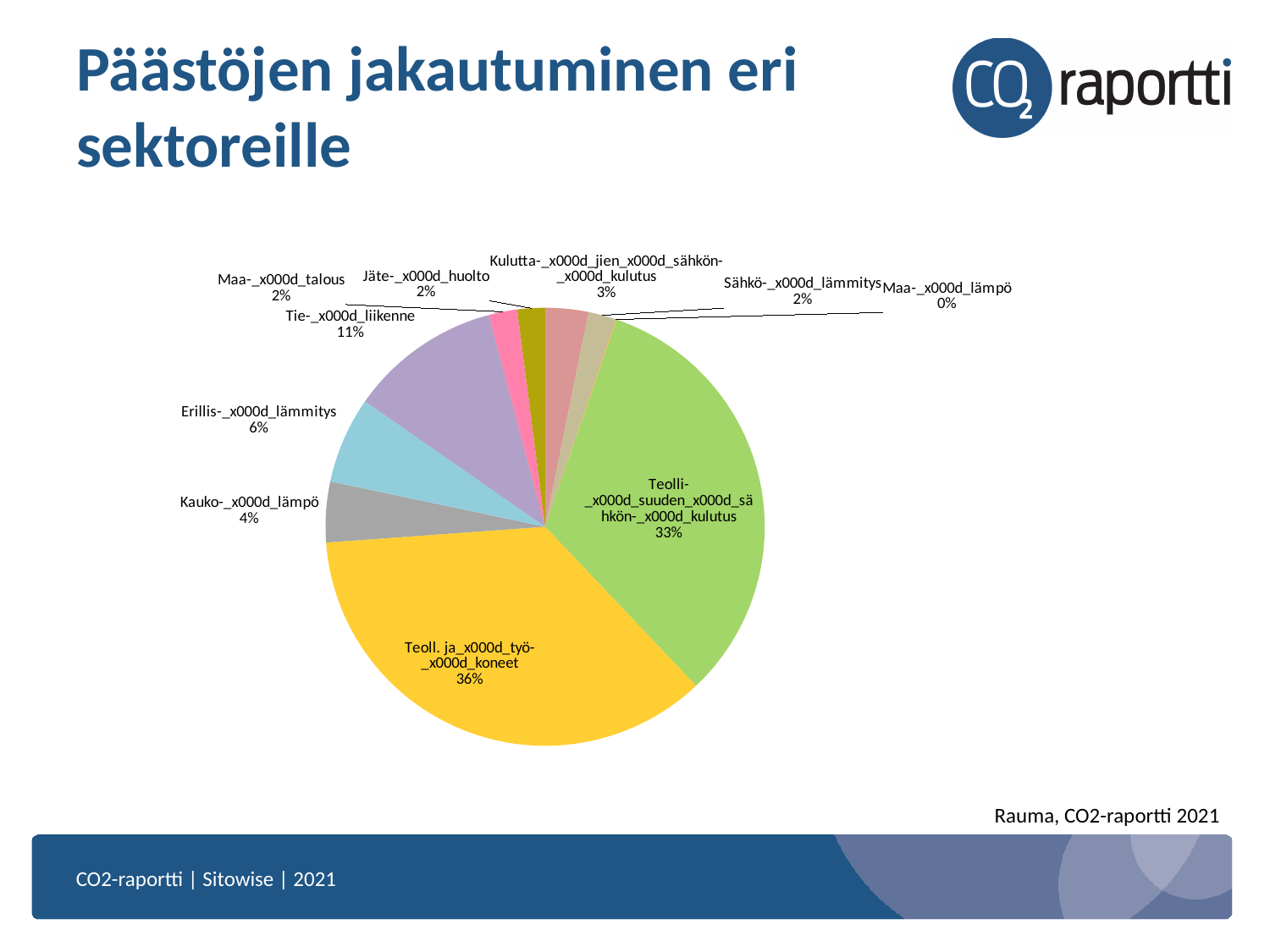
What percentage is shown for the slice labelled 'Kulutta-_x000d_jien_x000d_sähkön-_x000d_kulutus'? 3% How many slices does the pie chart have? 10 Which slice is larger, 'Tie-_x000d_liikenne' or 'Erillis-_x000d_lämmitys'? Tie-_x000d_liikenne Which slice of the pie chart has the smallest share? Maa-_x000d_lämpö (0%) What share of the pie does the slice labelled 'Tie-_x000d_liikenne' have? 11% What is the title of the chart slide? Päästöjen jakautuminen eri sektoreille What percentage is shown for the slice labelled 'Kauko-_x000d_lämpö'? 4% What share of the pie does the slice labelled 'Teolli-_x000d_suuden_x000d_sähkön-_x000d_kulutus' have? 33% What percentage is shown for the slice labelled 'Erillis-_x000d_lämmitys'? 6% What is the difference in percentage points between the 'Teoll. ja_x000d_työ-_x000d_koneet' slice and the 'Teolli-_x000d_suuden_x000d_sähkön-_x000d_kulutus' slice? 3 percentage points Which slice of the pie chart has the largest share? Teoll. ja_x000d_työ-_x000d_koneet (36%) What kind of chart is shown on the slide? pie chart